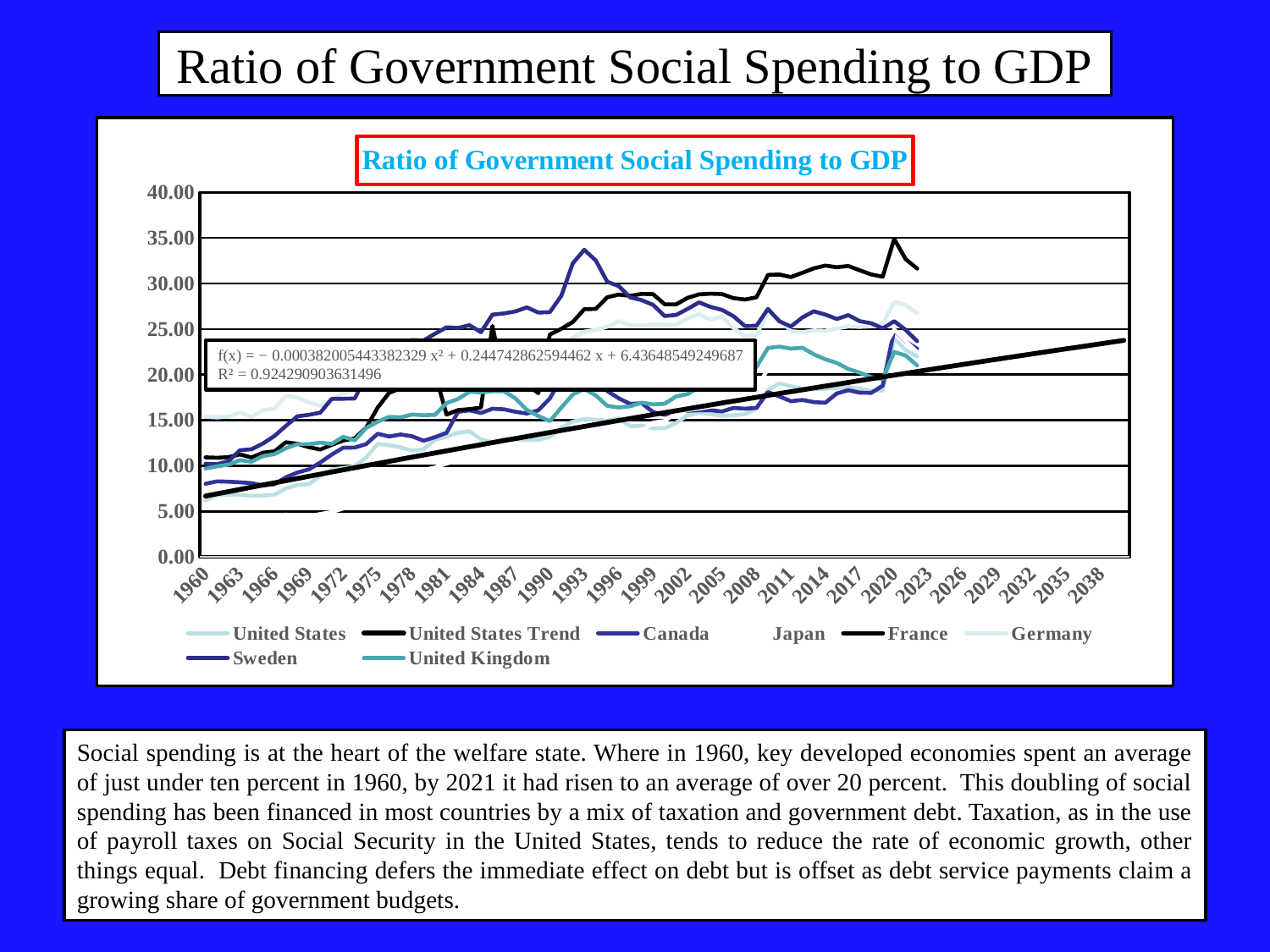
Is the value for the United States Trend line at 2038 greater or less than 20? greater How many series does the legend list? 8 What is the last year labelled on the horizontal axis? 2038 What is the R² value printed on the chart? 0.924290903631496 Around 2020, which series has the highest value? France Is the value for the United States Trend line at 1960 greater or less than 10? less Is the value for Canada around 1993 greater or less than 30? less What is the highest value shown on the vertical axis? 40.00 Does the United States Trend line rise or fall from 1960 to 2038? Rises What is the title of the chart? Ratio of Government Social Spending to GDP What kind of chart is shown on the slide? Line chart